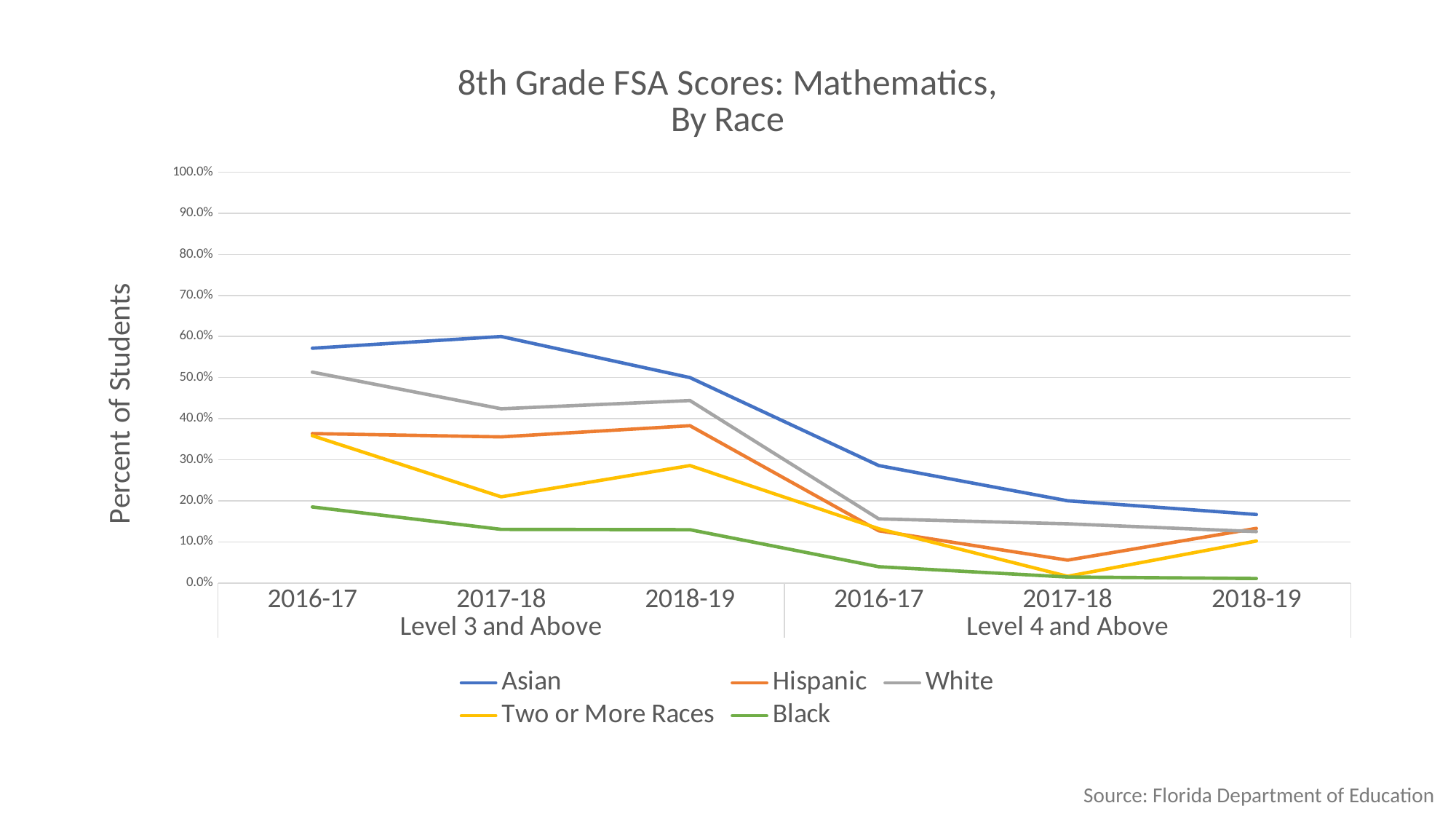
What kind of chart is shown on the slide? Line chart Is the value for Black in 2018-19 under Level 4 and Above greater or less than 10.0%? less Is the value for Asian in 2016-17 under Level 3 and Above greater or less than 50.0%? greater Which race has the lowest value for 2016-17 under Level 3 and Above? Black Which race has the highest value for 2016-17 under Level 3 and Above? Asian Does the Asian line rise or fall across the three years under Level 4 and Above? Fall How many series does the legend list? 5 Is the value for Asian in 2016-17 under Level 4 and Above greater or less than 30.0%? less For 2018-19 under Level 3 and Above, which is larger, the value for White or the value for Hispanic? White How many points are there along the x axis? 6 What is the label on the y axis of the chart? Percent of Students